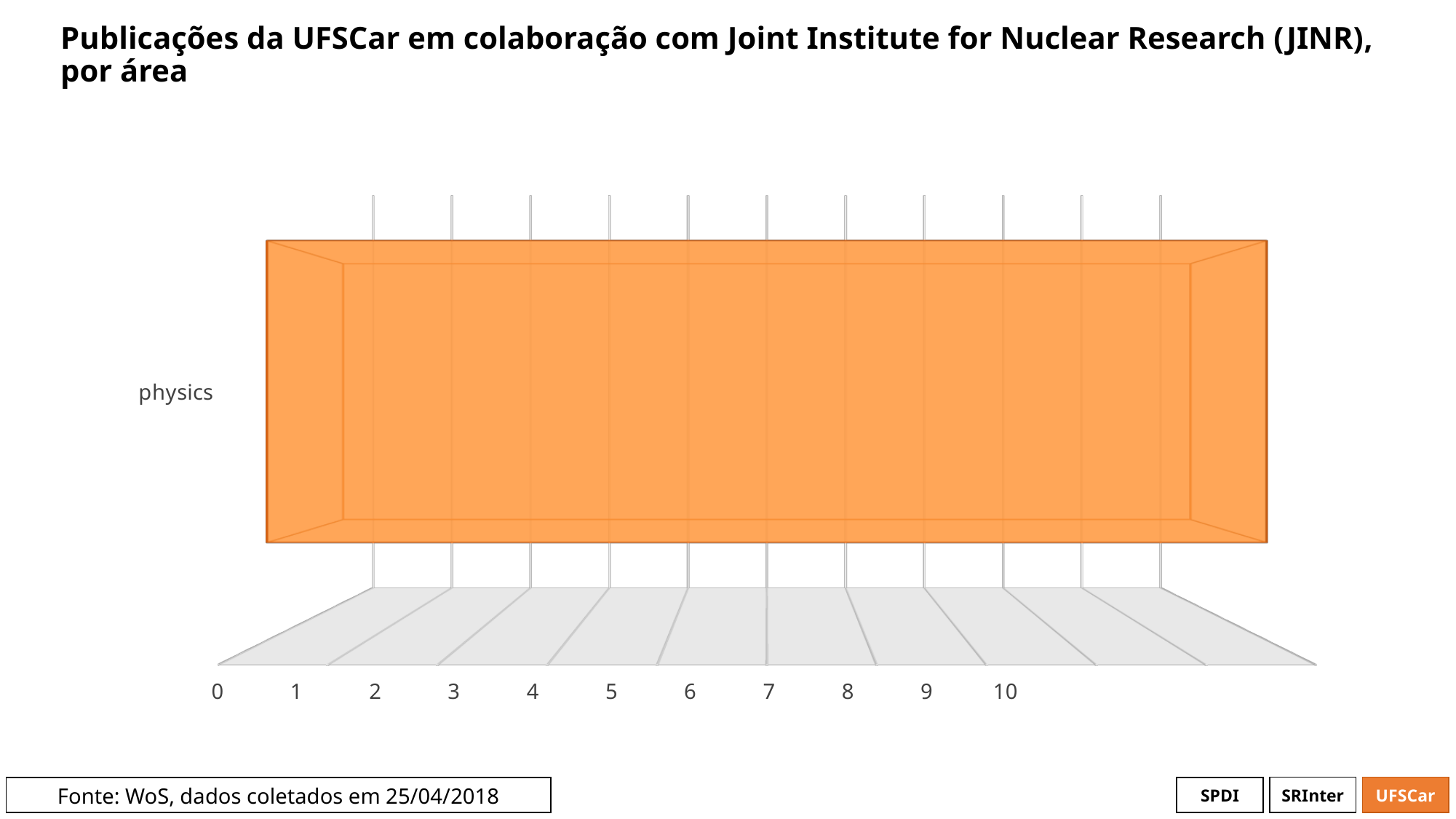
Which area is shown as a category in the chart? physics What kind of chart is shown on the slide? bar chart Is the value for physics greater or less than 5? greater How many categories are plotted in the chart? 1 Is the value for physics greater or less than 10? greater What is the highest labelled tick on the horizontal axis? 10 What colour is the bar for physics? orange